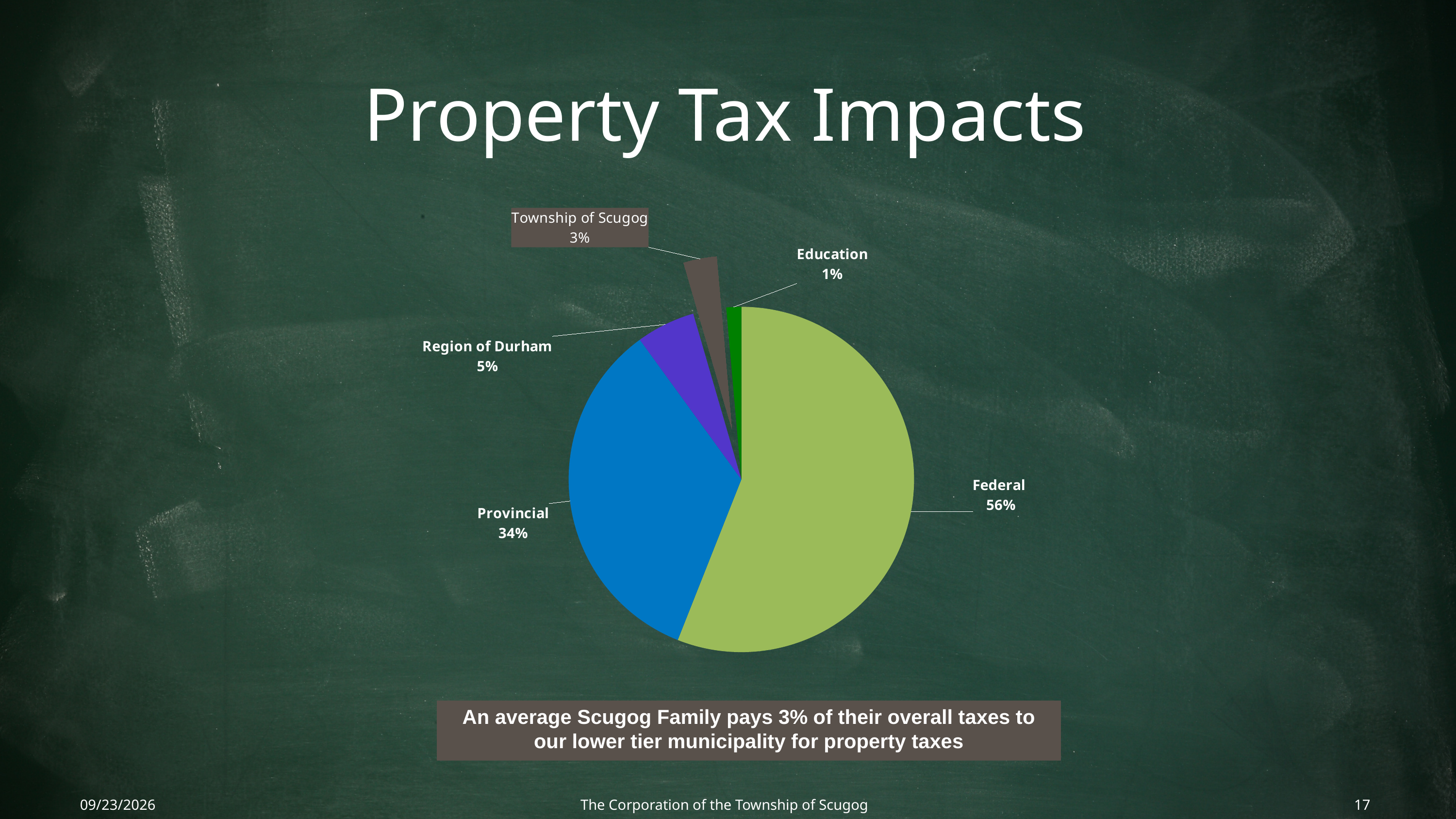
What kind of chart is shown on the slide? Pie chart How many categories are shown in the pie chart? 5 What is the value shown for Township of Scugog? 3% Which slice is pulled out (exploded) from the pie? Township of Scugog What is the value shown for Region of Durham? 5% What is the difference between the Federal and Provincial shares? 22% What share of the pie does Federal represent? 56% Which category has the smallest slice of the pie? Education What share of the pie does Provincial represent? 34% Which is larger, Region of Durham or Township of Scugog? Region of Durham What is the value shown for Education? 1% Which category has the largest slice of the pie? Federal